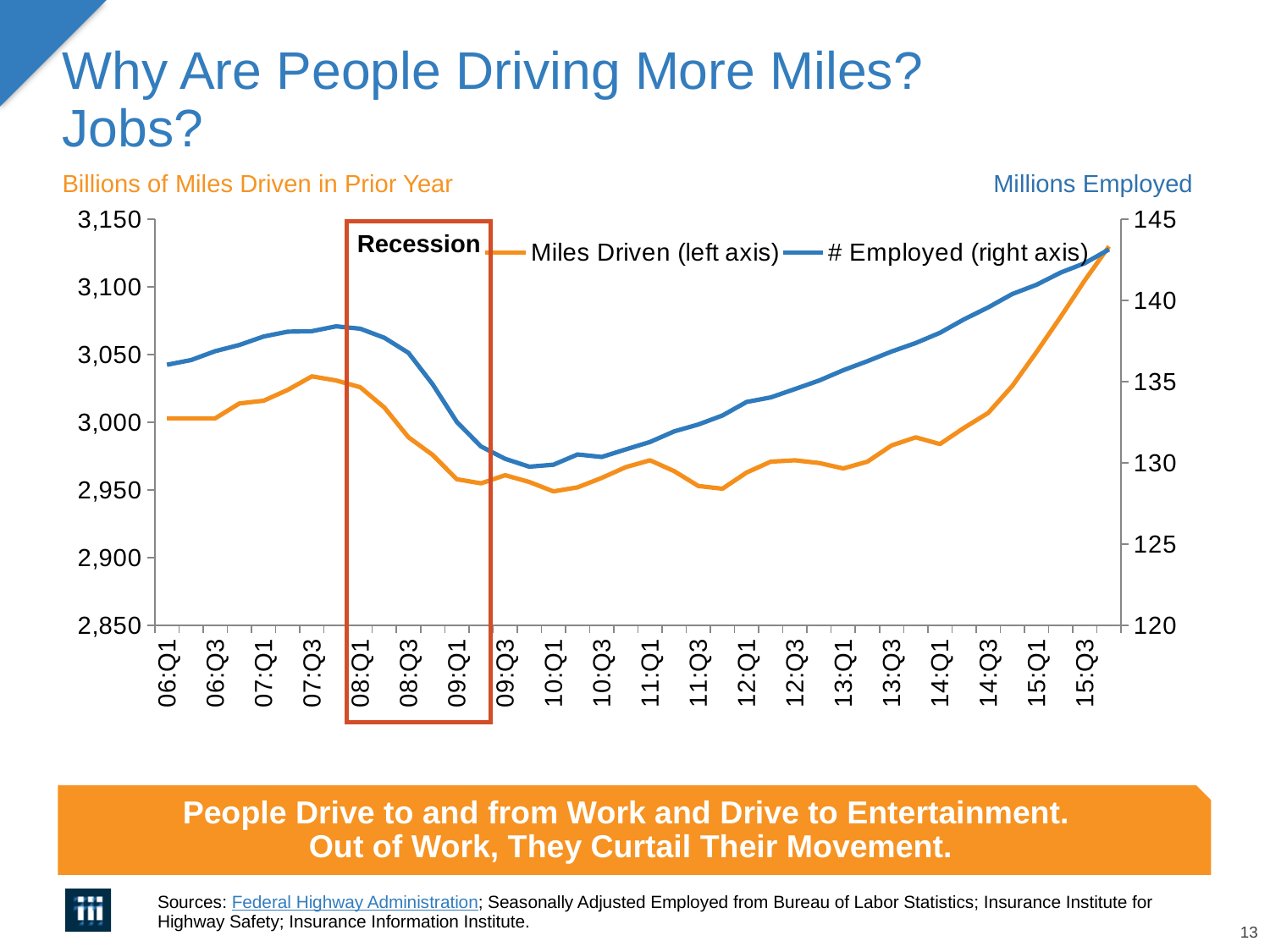
Is the value for Miles Driven at 11:Q3 greater or less than 3,000? less What kind of chart is shown on the slide? Line chart Is the value for Miles Driven at 07:Q3 greater or less than 3,000? greater Which series is plotted against the right axis? # Employed What label appears inside the red box on the chart? Recession Is the value for # Employed at 12:Q1 greater or less than 135? less How many series does the legend list? 2 Does the # Employed series rise or fall from 08:Q1 to 10:Q1? Fall